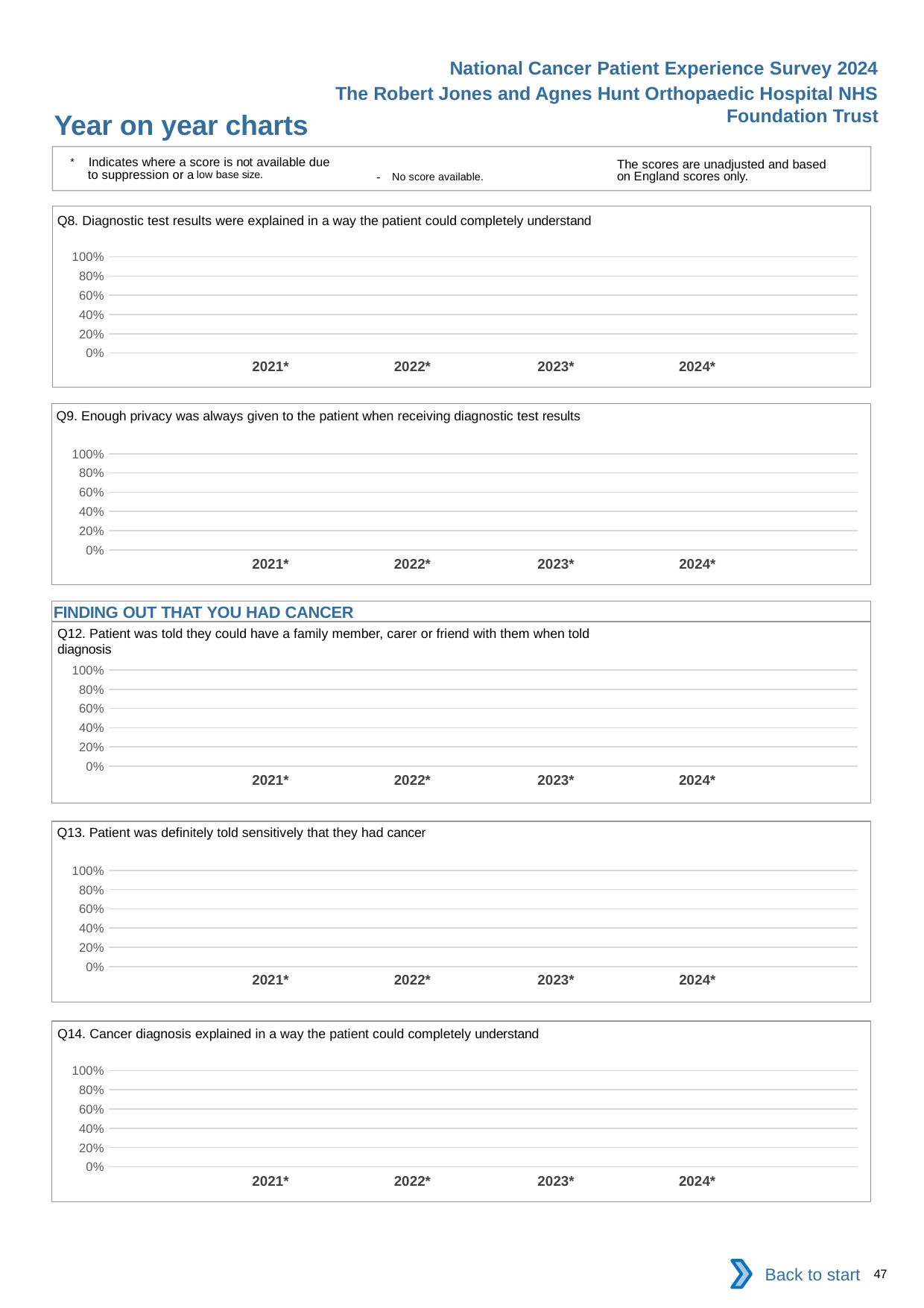
According to the key on the slide, what does the asterisk next to the year labels indicate? A score is not available due to suppression or a low base size On the Q9 chart, what is the highest value marked on the y axis? 100% On the Q13 chart, how many year categories are shown on the x axis? 4 On the Q8 chart, how many year categories are shown on the x axis? 4 How many charts are shown on the slide? 5 On the Q12 chart, what is the first year label on the x axis? 2021* What is the title of the first chart shown under the heading 'FINDING OUT THAT YOU HAD CANCER'? Q12. Patient was told they could have a family member, carer or friend with them when told diagnosis On the Q9 chart, what is the lowest value marked on the y axis? 0% On the Q14 chart, what is the last year label on the x axis? 2024*